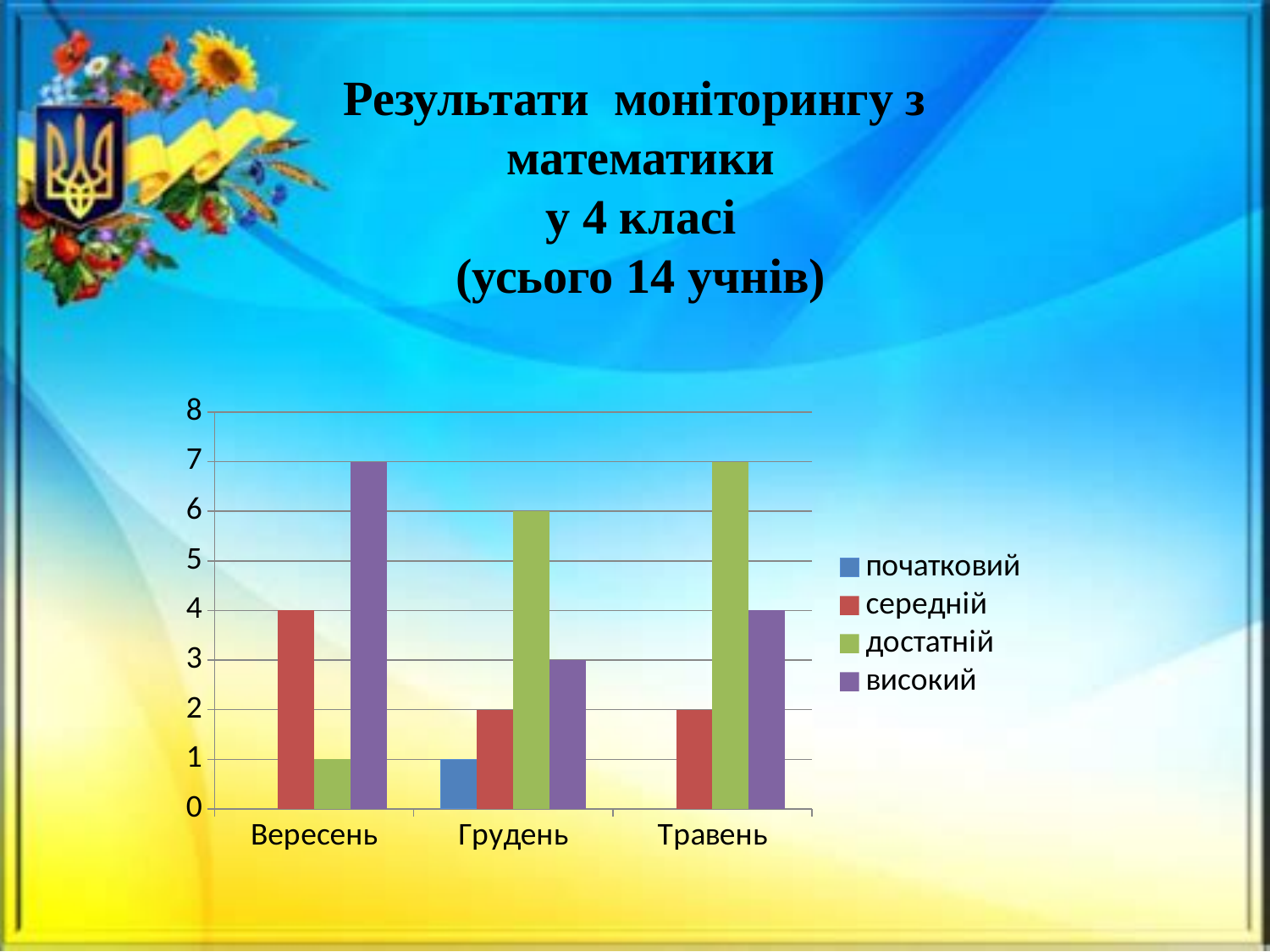
What is the value for достатній in Грудень? 6 In which category is the value for високий lowest? Грудень What is the value for середній in Вересень? 4 How many series does the legend list? 4 In which category is the value for достатній highest? Травень What is the value for початковий in Грудень? 1 What is the value for високий in Вересень? 7 How many categories are shown on the x axis? 3 What kind of chart is shown on the slide? bar chart Which is larger: середній in Вересень or середній in Травень? середній in Вересень Which series is shown in purple in the legend? високий What is the difference between достатній in Травень and достатній in Вересень? 6